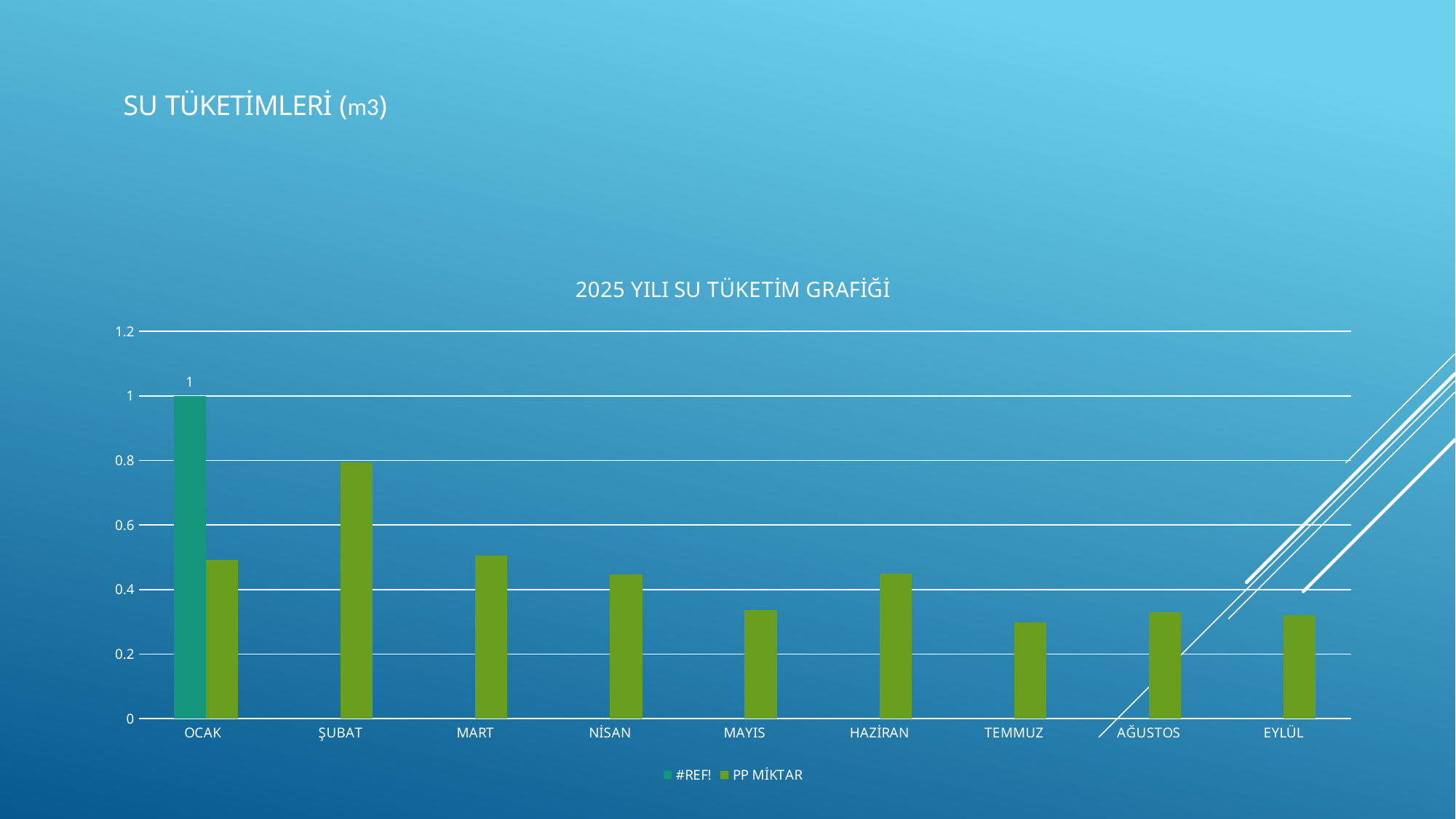
What type of chart is shown on the slide? bar chart Which month has the highest PP MİKTAR value? ŞUBAT For OCAK, which series has the larger value, #REF! or PP MİKTAR? #REF! What is the title of the chart? 2025 YILI SU TÜKETİM GRAFİĞİ Is the PP MİKTAR value for MAYIS greater or less than 0.4? less Which is larger, the PP MİKTAR value for MART or for MAYIS? MART Is the PP MİKTAR value for ŞUBAT greater or less than 0.6? greater Is the PP MİKTAR value for TEMMUZ greater or less than 0.4? less What is the value of the #REF! series for OCAK? 1 How many series does the legend list? 2 How many months are shown on the x axis? 9 Which is larger, the PP MİKTAR value for ŞUBAT or for MART? ŞUBAT